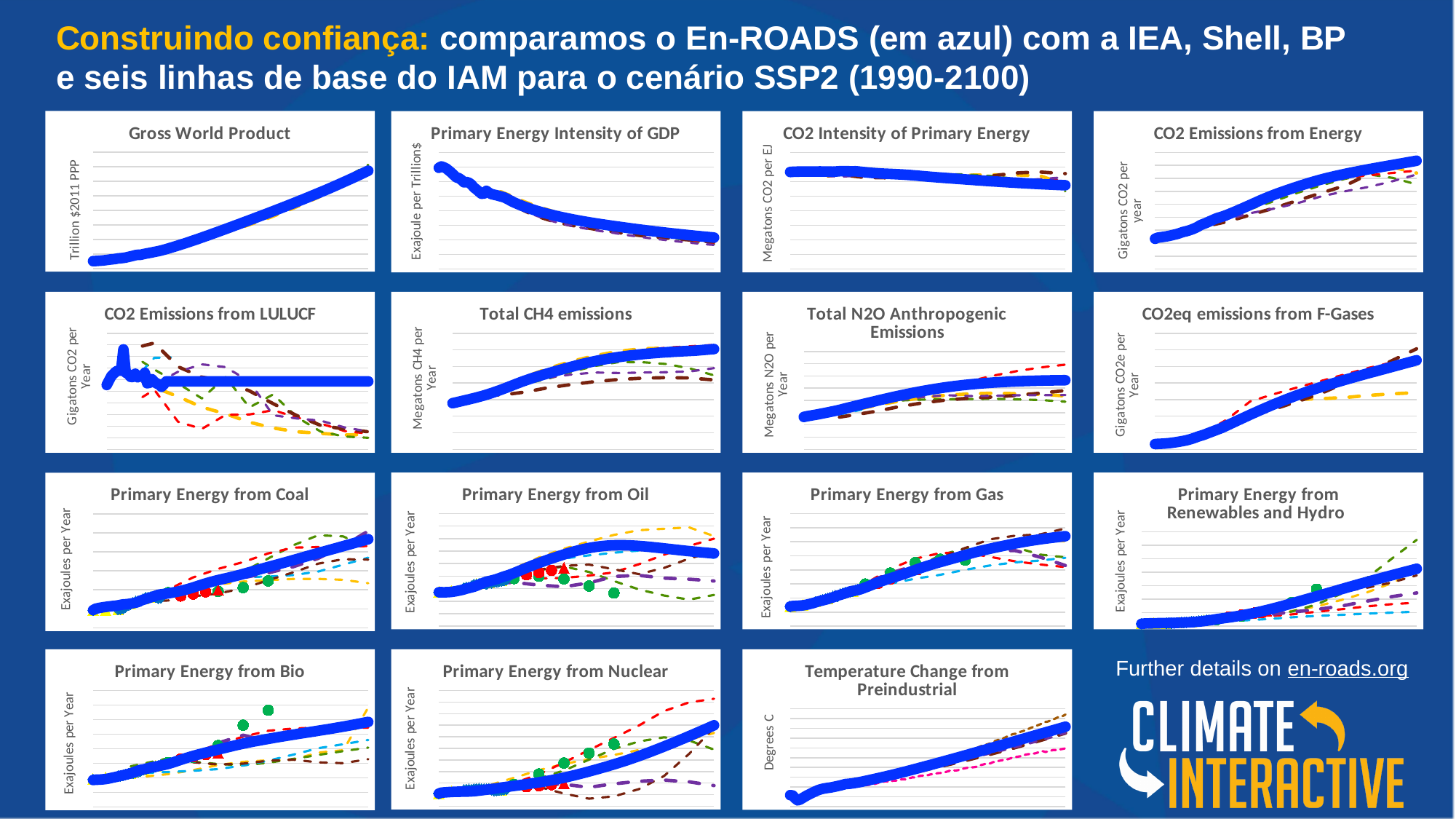
How many charts are shown on the slide? 15 In the "CO2 Emissions from Energy" chart, does the blue line rise or fall from left to right? rise What is the y-axis label of the "Gross World Product" chart? Trillion $2011 PPP What kind of chart is the "Gross World Product" chart? line chart In the "CO2eq emissions from F-Gases" chart, does the blue line rise or fall from left to right? rise In the "Temperature Change from Preindustrial" chart, does the blue line rise or fall over time? rise What kind of chart is the "Primary Energy from Coal" chart? line chart What is the y-axis label of the "Temperature Change from Preindustrial" chart? Degrees C